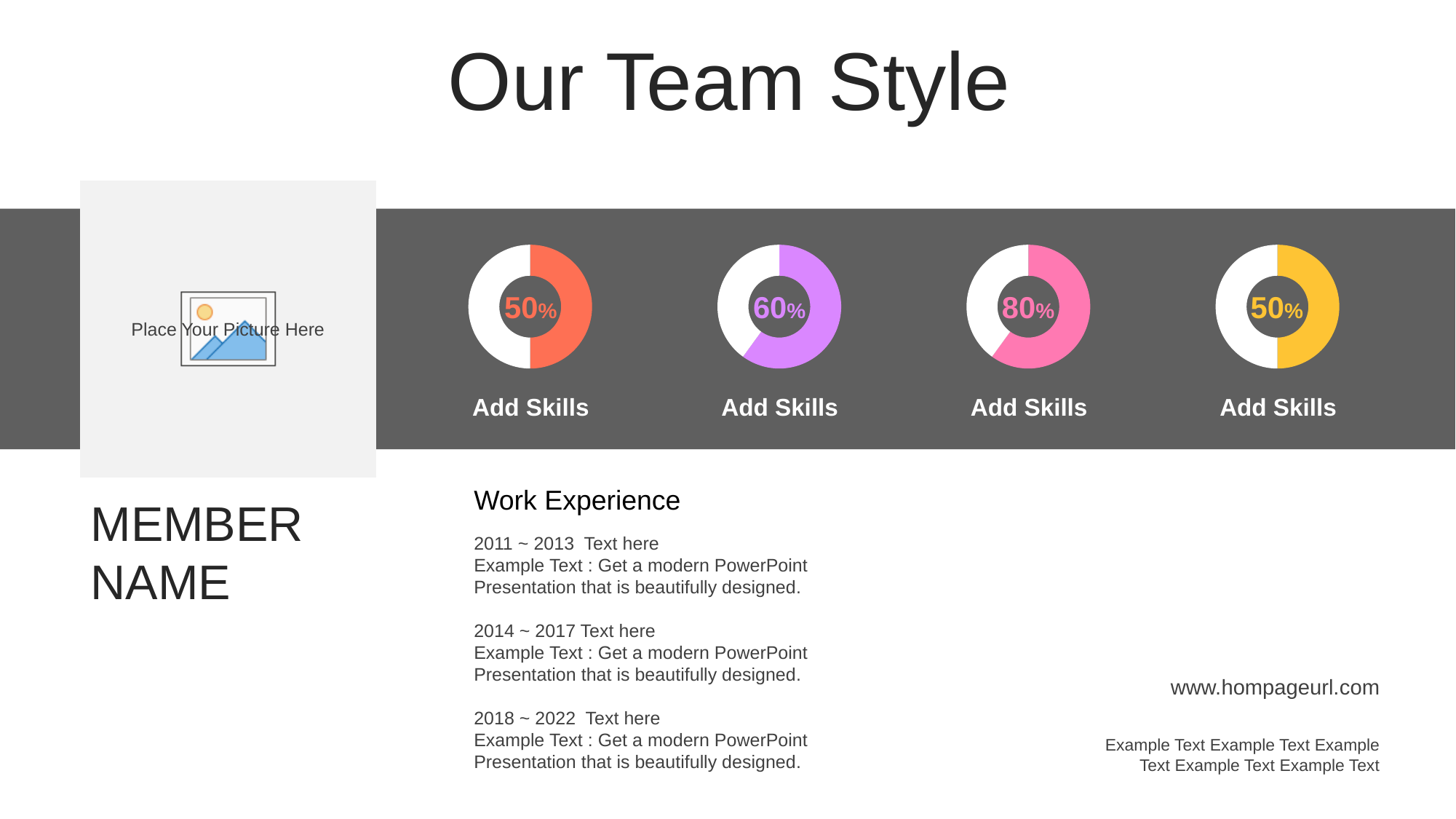
What label appears beneath each of the four donut charts? Add Skills What kind of chart is used to display the skill percentages? Donut chart Which of the four donut charts shows the highest percentage? The third (pink) chart, 80% How many donut charts are shown on the slide? 4 What value is shown in the third (pink) donut chart from the left? 80% What colour is the filled portion of the third donut chart from the left? Pink What value is shown in the leftmost (orange) donut chart? 50% What value is shown in the rightmost (yellow) donut chart? 50% Which is larger, the value in the purple donut chart or the value in the yellow donut chart? The purple donut chart (60%) What is the difference between the value in the pink donut chart and the value in the orange donut chart? 30% What value is shown in the second (purple) donut chart from the left? 60% What is the difference between the value in the pink donut chart and the value in the purple donut chart? 20%